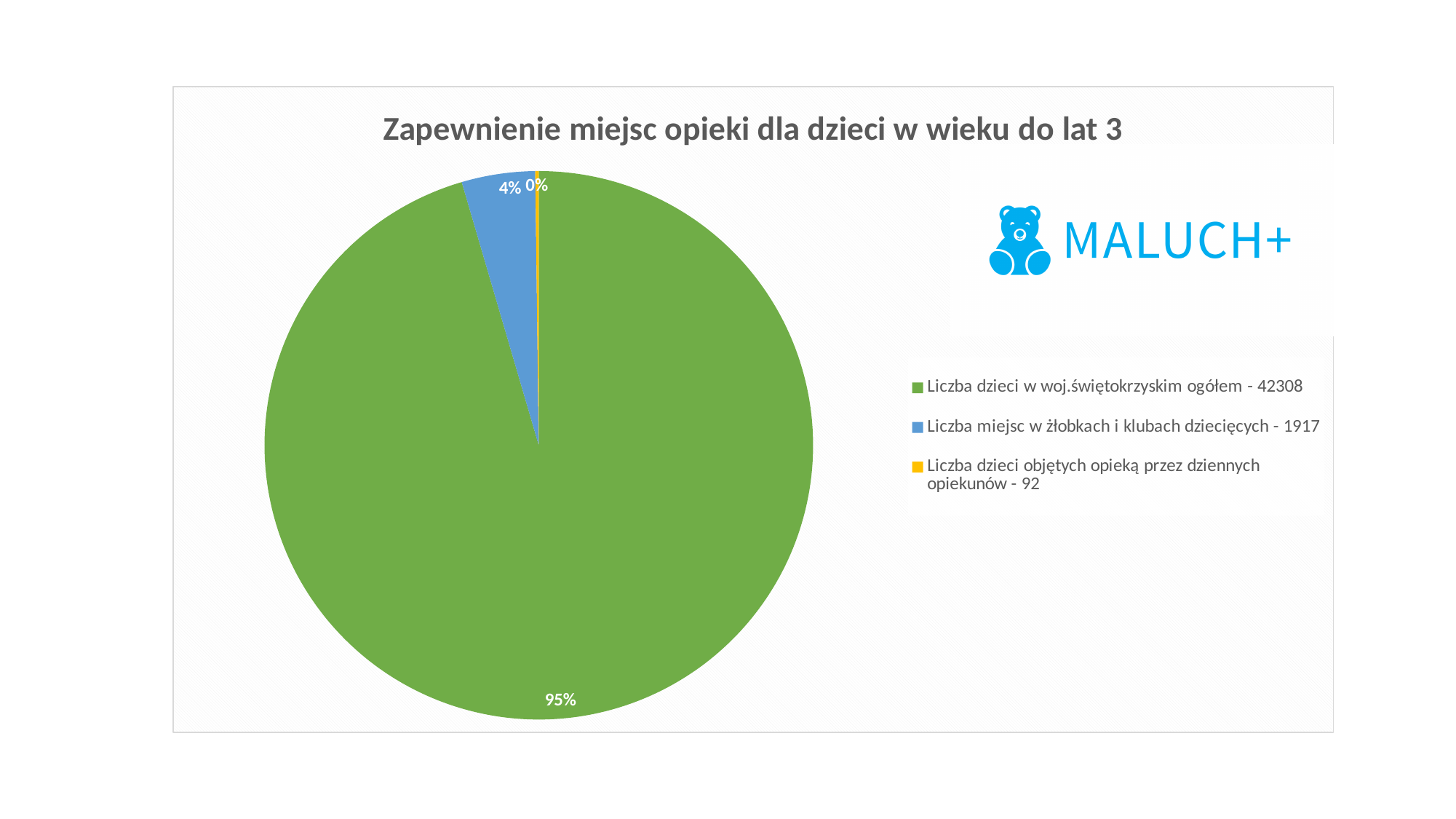
What is the difference in percentage points between the 95% slice and the 4% slice? 91% Which category has the smallest slice of the pie? Liczba dzieci objętych opieką przez dziennych opiekunów What share of the pie does 'Liczba miejsc w żłobkach i klubach dziecięcych' take? 4% What share of the pie does 'Liczba dzieci w woj.świętokrzyskim ogółem' take? 95% Which is larger: the slice for 'Liczba miejsc w żłobkach i klubach dziecięcych' or the slice for 'Liczba dzieci objętych opieką przez dziennych opiekunów'? Liczba miejsc w żłobkach i klubach dziecięcych What is the title of the chart? Zapewnienie miejsc opieki dla dzieci w wieku do lat 3 Which category has the largest slice of the pie? Liczba dzieci w woj.świętokrzyskim ogółem What number is given in the legend for 'Liczba miejsc w żłobkach i klubach dziecięcych'? 1917 What colour is the slice for 'Liczba dzieci objętych opieką przez dziennych opiekunów'? yellow What share of the pie is labelled for 'Liczba dzieci objętych opieką przez dziennych opiekunów'? 0% What kind of chart is shown on the slide? pie chart How many slices does the pie chart have? 3